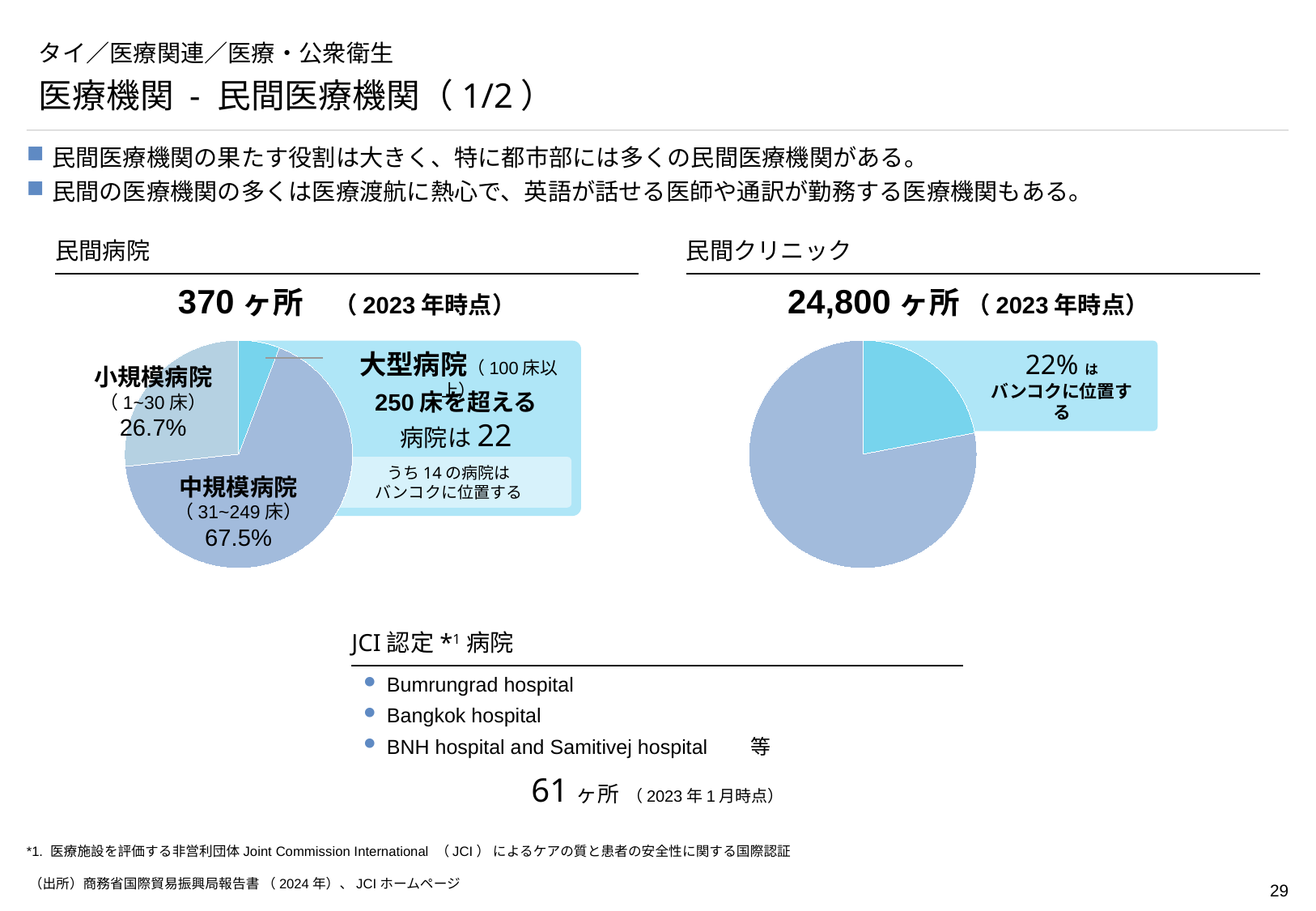
What kind of chart is used for 民間病院? Pie chart On the 民間病院 pie chart, which category has the largest slice? 中規模病院 How many slices does the 民間病院 pie chart have? 3 On the 民間病院 pie chart, what share is shown for 小規模病院? 26.7% On the 民間病院 pie chart, which category has the smallest slice? 大型病院 What total number of 民間クリニック is shown above the right pie chart? 24,800 ヶ所 How many slices does the 民間クリニック pie chart have? 2 On the 民間病院 pie chart, what share is shown for 中規模病院? 67.5% On the 民間クリニック pie chart, what share of clinics is located in Bangkok? 22% On the 民間病院 pie chart, what is the difference in percentage points between 中規模病院 and 小規模病院? 40.8 On the 民間病院 pie chart, which is larger, the slice for 小規模病院 or the slice for 大型病院? 小規模病院 What total number of 民間病院 is shown above the left pie chart? 370 ヶ所